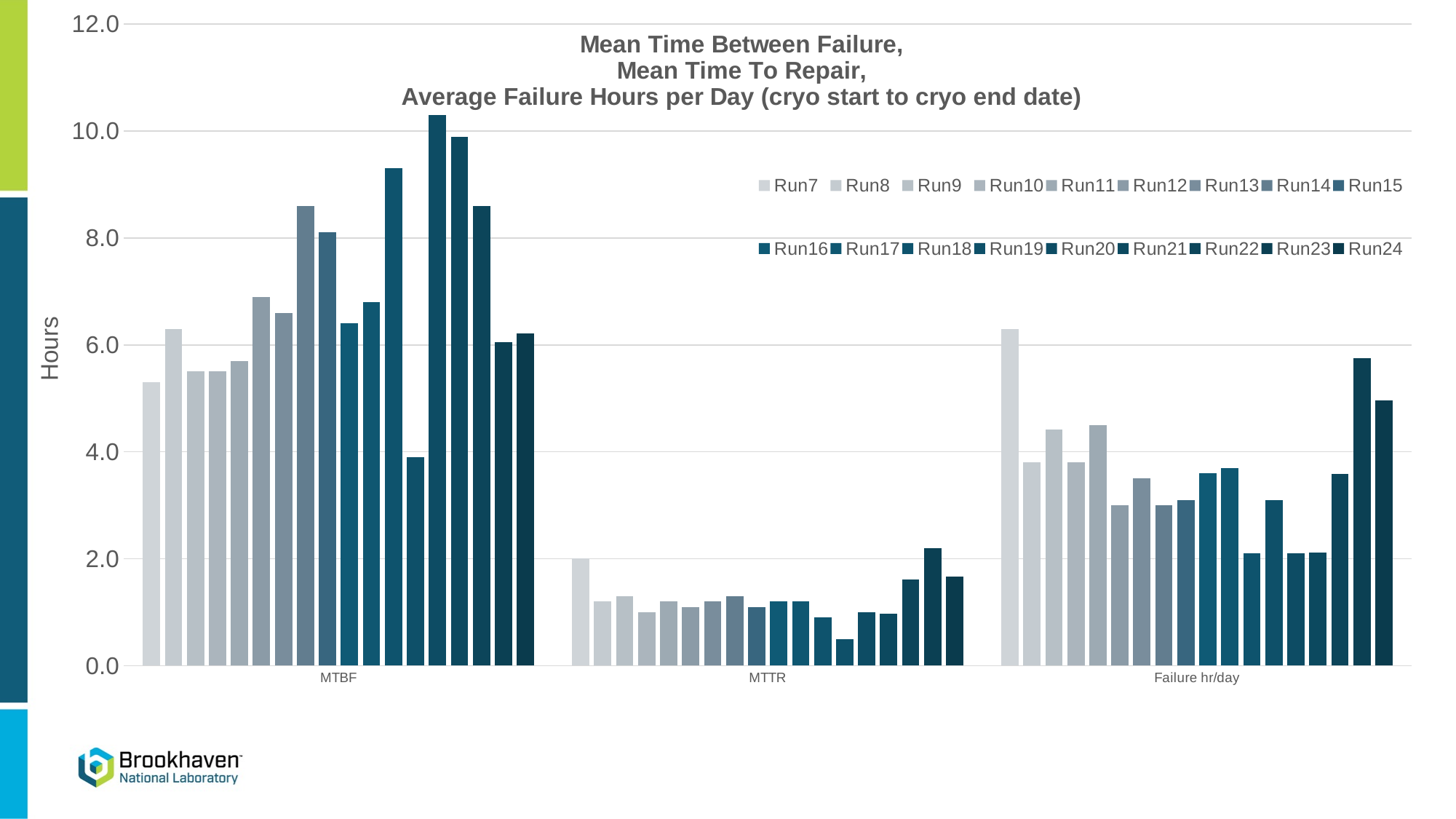
Which is larger: the Run7 bar for MTBF or the Run7 bar for MTTR? MTBF What are the three category labels on the x axis? MTBF, MTTR, Failure hr/day What kind of chart is shown on the slide? Bar chart Which category has the lowest values overall? MTTR Is the value for Run24 in the Failure hr/day category greater or less than 4.0? greater Is the value for Run7 in the MTBF category greater or less than 6.0? less What is the label of the y axis? Hours Which category has the tallest bars overall? MTBF Is the tallest bar in the MTBF category greater or less than 8.0? greater How many categories are shown along the x axis? 3 How many series does the legend list? 18